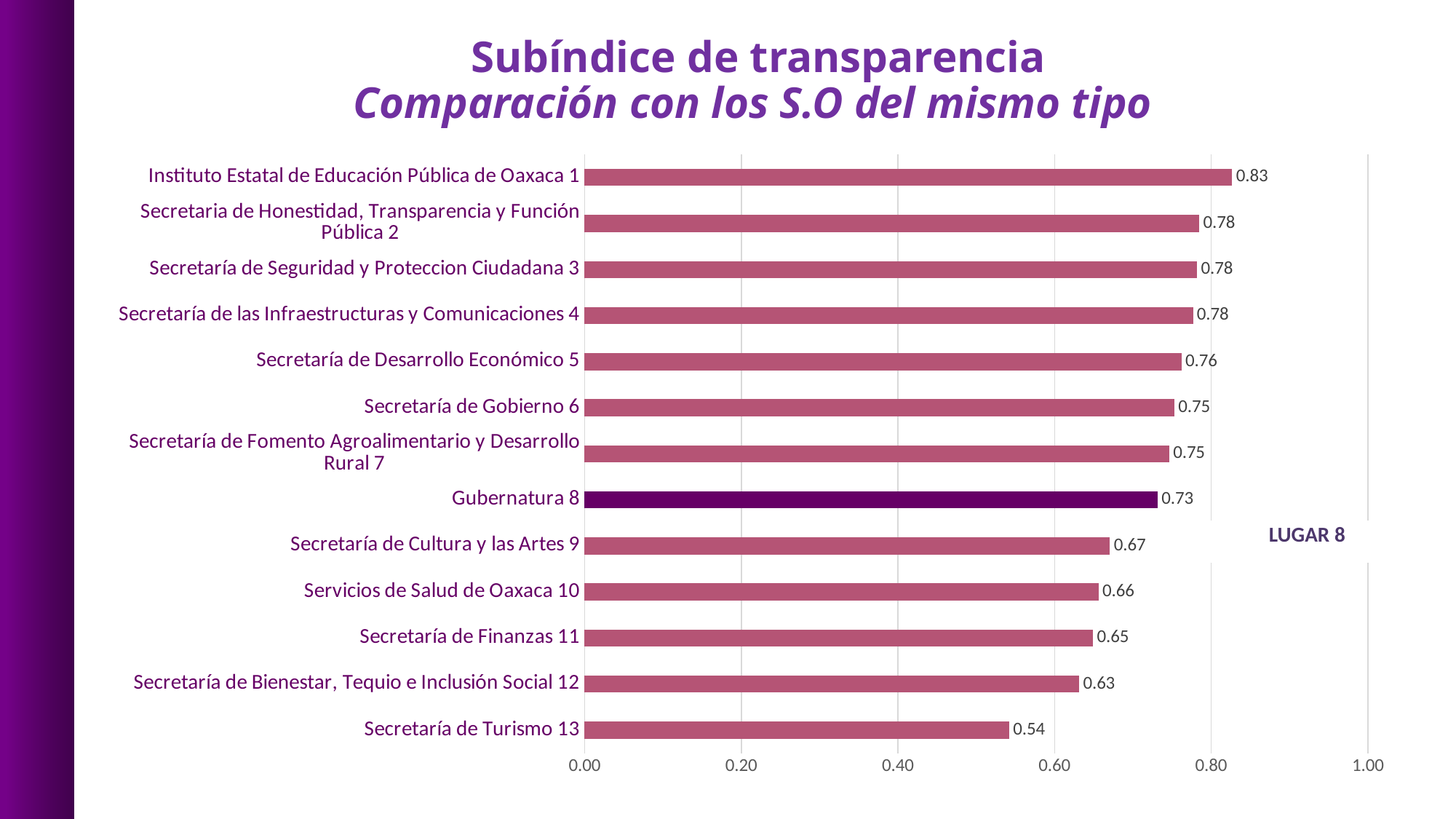
Which is larger, the value for Secretaría de Gobierno 6 or the value for Servicios de Salud de Oaxaca 10? Secretaría de Gobierno 6 What is the value for Secretaría de Turismo 13? 0.54 What is the difference between the values for Gubernatura 8 and Secretaría de Cultura y las Artes 9? 0.06 Is the value for Secretaría de Bienestar, Tequio e Inclusión Social 12 greater or less than 0.60? greater What is the title of the chart? Subíndice de transparencia Comparación con los S.O del mismo tipo Which category has the highest value? Instituto Estatal de Educación Pública de Oaxaca 1 What is the difference between the values for Instituto Estatal de Educación Pública de Oaxaca 1 and Secretaría de Turismo 13? 0.29 What kind of chart is shown on the slide? bar chart What is the value for Gubernatura 8? 0.73 How many categories are shown in the chart? 13 Which category has the lowest value? Secretaría de Turismo 13 What is the value for Secretaría de Finanzas 11? 0.65